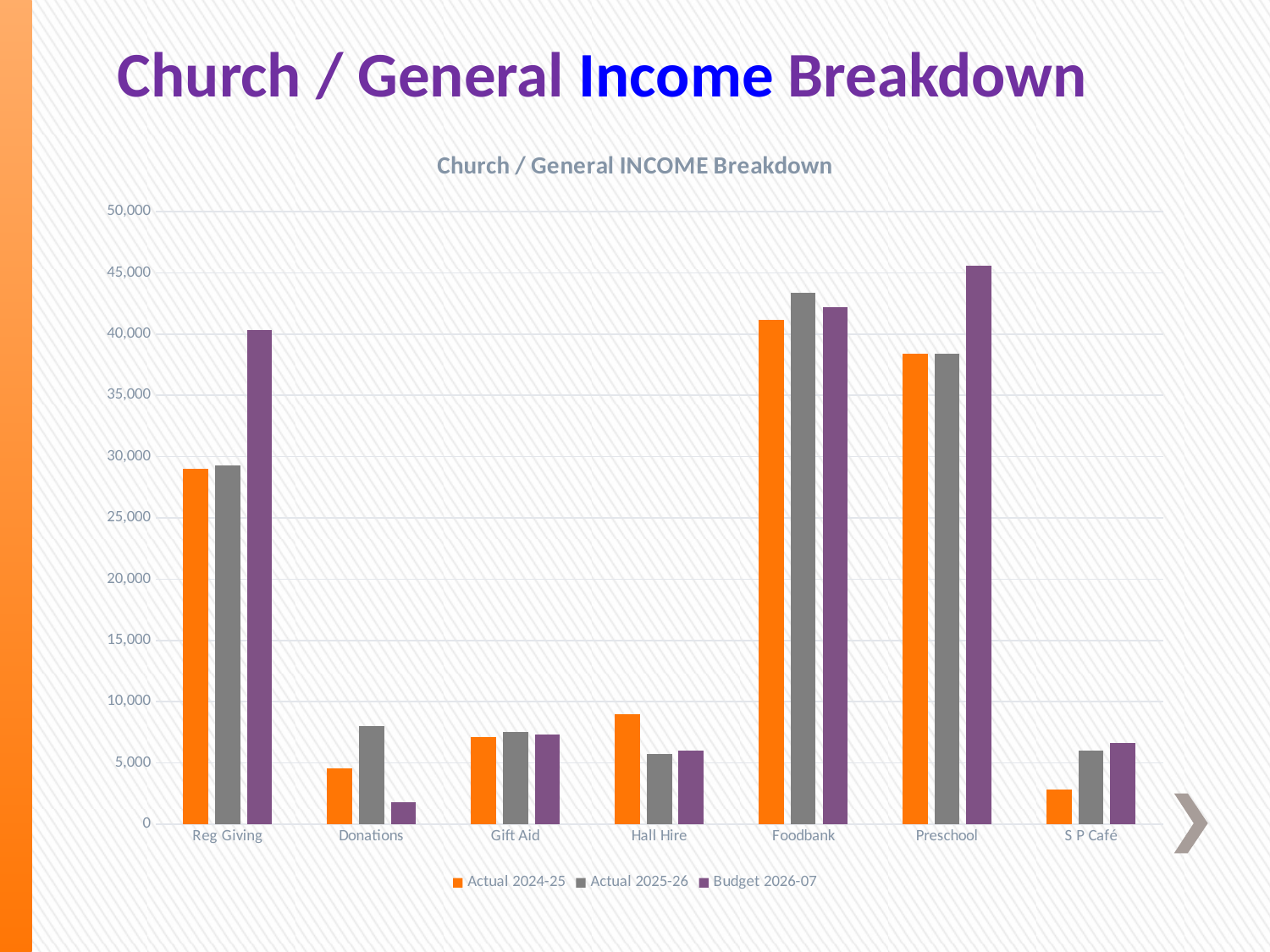
How many categories are shown on the x axis? 7 Which category has the highest Actual 2025-26 value? Foodbank Which category has the lowest Actual 2024-25 value? S P Café Is the Budget 2026-07 value for Reg Giving greater or less than 35,000? greater How many series does the legend list? 3 For Donations, which is larger: Actual 2025-26 or Budget 2026-07? Actual 2025-26 Which category has the lowest Budget 2026-07 value? Donations Which category has the highest Budget 2026-07 value? Preschool For Hall Hire, which is larger: Actual 2024-25 or Actual 2025-26? Actual 2024-25 What kind of chart is shown on the slide? bar chart Is the Actual 2024-25 value for S P Café greater or less than 5,000? less Is the Actual 2025-26 value for Foodbank greater or less than 45,000? less